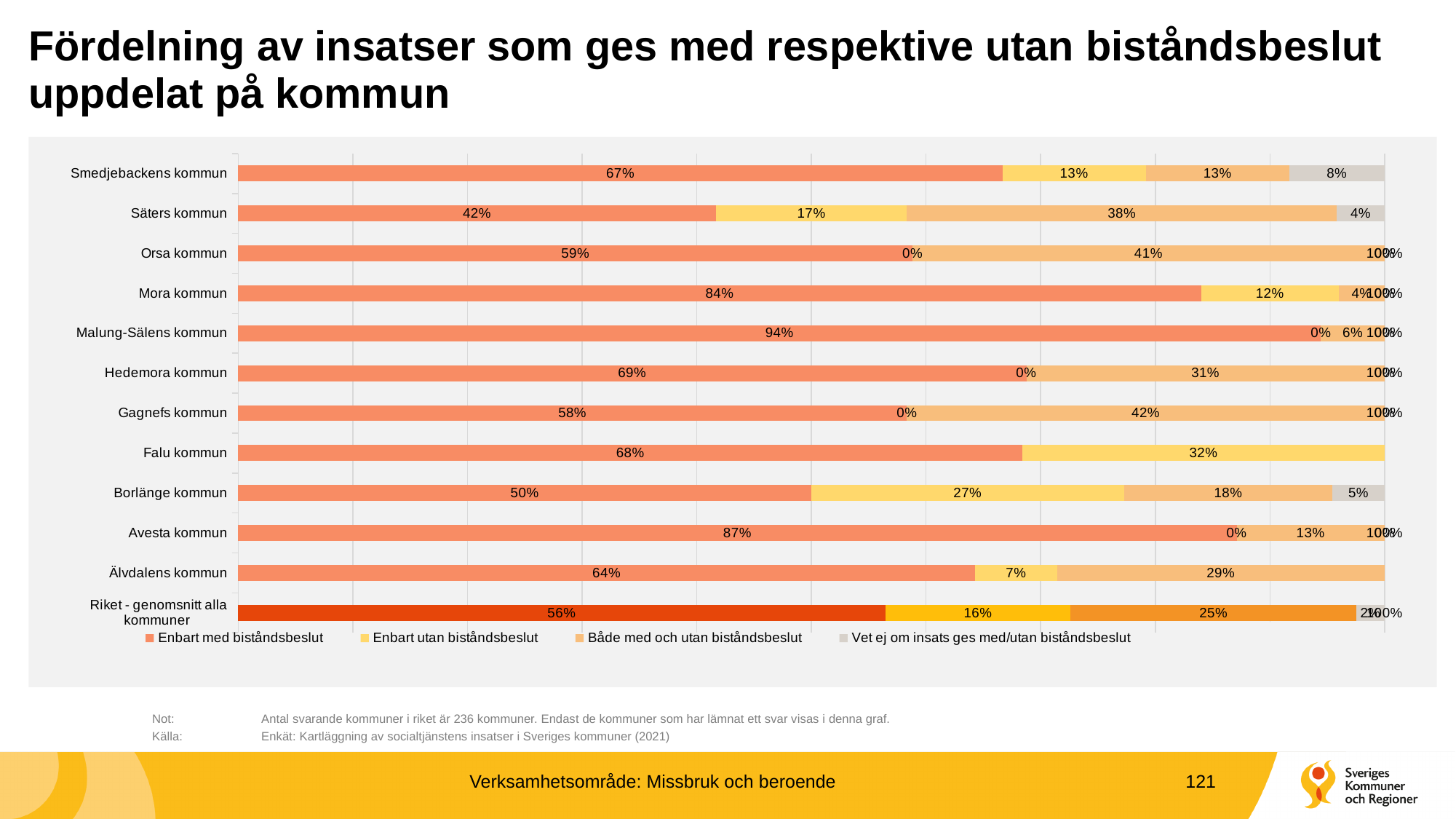
How many series does the legend list? 4 How many categories (bars) are shown on the chart? 12 What is the value of 'Enbart med biståndsbeslut' for Malung-Sälens kommun? 94% What is the value of 'Vet ej om insats ges med/utan biståndsbeslut' for Smedjebackens kommun? 8% Which category has the lowest value for 'Enbart med biståndsbeslut'? Säters kommun What is the 'Enbart med biståndsbeslut' value for 'Riket - genomsnitt alla kommuner'? 56% What is the value of 'Både med och utan biståndsbeslut' for Säters kommun? 38% What kind of chart is shown on the slide? Stacked bar chart What is the value of 'Enbart utan biståndsbeslut' for Borlänge kommun? 27% Which category has the highest value for 'Enbart med biståndsbeslut'? Malung-Sälens kommun What is the difference between the 'Enbart med biståndsbeslut' values for Avesta kommun and Falu kommun? 19% Which has a larger 'Enbart utan biståndsbeslut' value, Falu kommun or Älvdalens kommun? Falu kommun